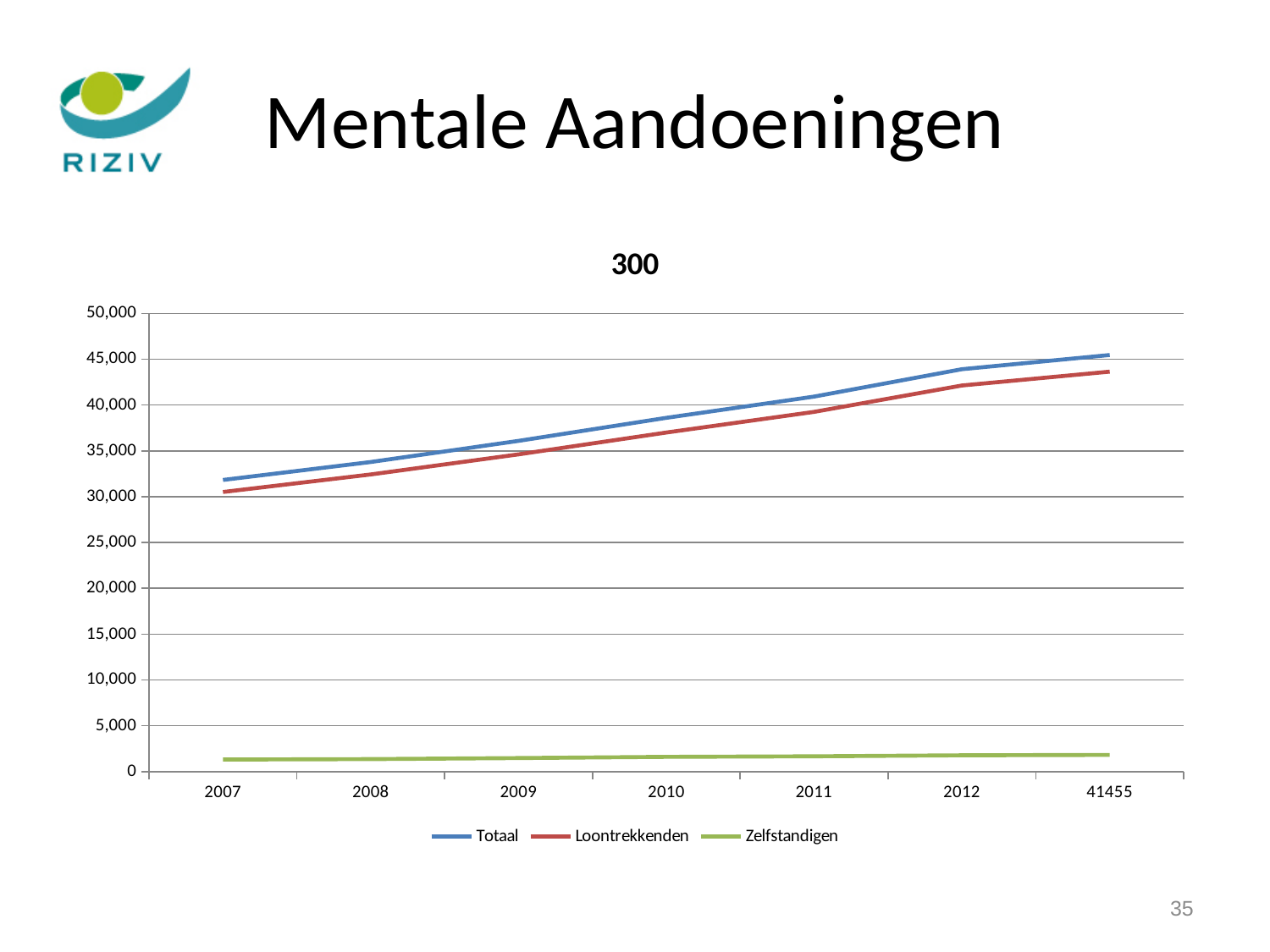
Which series has the lowest values throughout the chart? Zelfstandigen Does the Loontrekkenden series rise or fall across the x axis? rise What kind of chart is shown on the slide? line chart Does the Totaal series rise or fall from 2007 to the last point? rise How many series does the legend list? 3 Which is larger in 2011, Totaal or Zelfstandigen? Totaal What is the title of the chart? 300 Is the value for Loontrekkenden in 2012 greater or less than 40,000? greater Is the value for Zelfstandigen in 2010 greater or less than 5,000? less Is the value for Totaal in 2007 greater or less than 30,000? greater How many points are plotted along the x axis for each series? 7